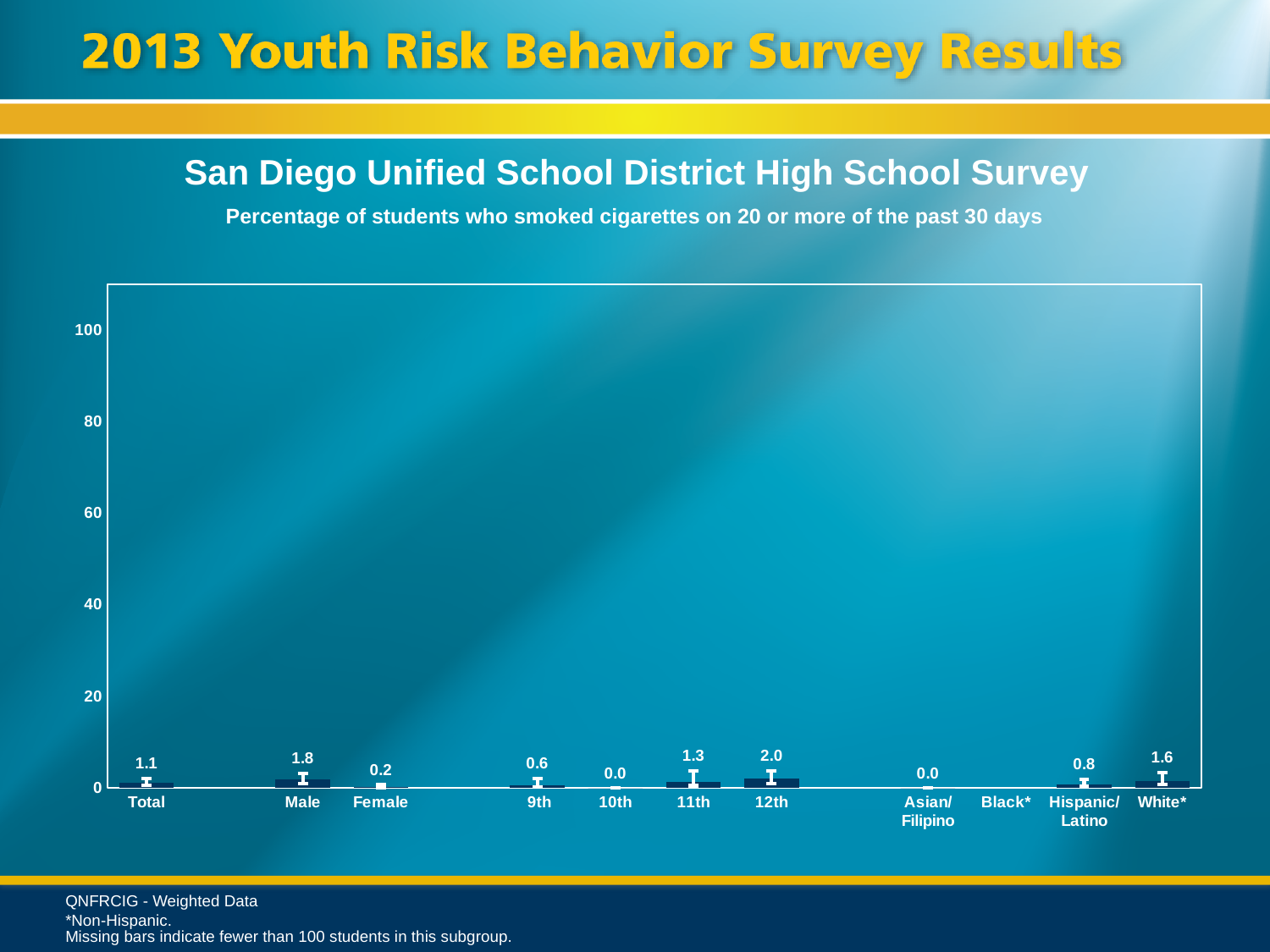
Which grade level has the lowest value? 10th Which is larger, the value for White* or the value for Hispanic/Latino? White* Is the value for 12th greater or less than 20? less Which category has no bar shown? Black* What is the value for Total? 1.1 Which category has the highest value? 12th What is the value for Hispanic/Latino? 0.8 How many category labels are shown on the x axis? 11 What kind of chart is shown on the slide? bar chart What is the difference between the values for Male and Female? 1.6 What is the value for Male? 1.8 What is the value for 12th? 2.0